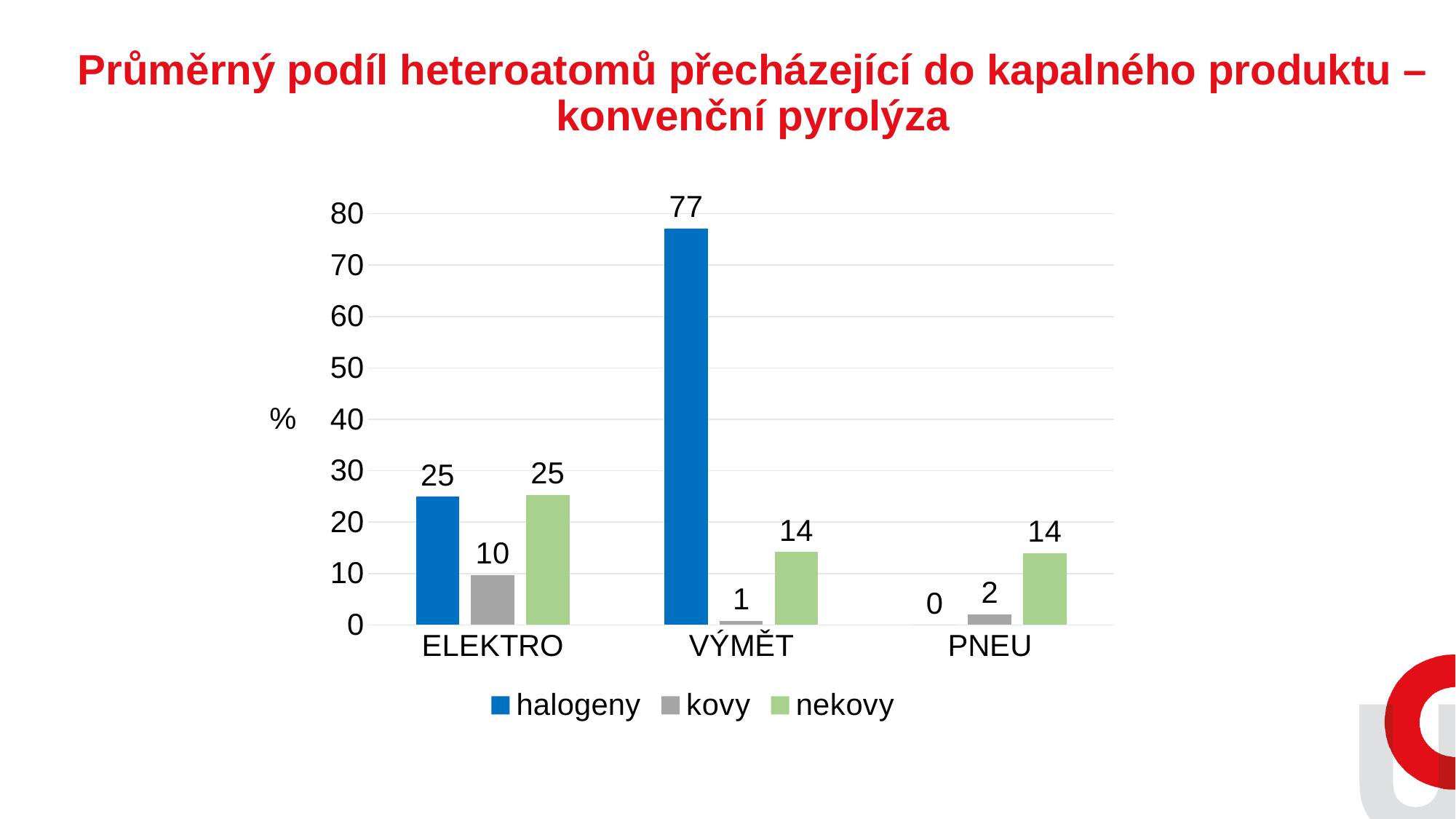
What is the value for kovy in the ELEKTRO category? 10 What is the value for halogeny in the VÝMĚT category? 77 What is the difference between the halogeny values for VÝMĚT and ELEKTRO? 52 What is the value for nekovy in the PNEU category? 14 What is the value for halogeny in the PNEU category? 0 Which is larger: the nekovy value for ELEKTRO or the nekovy value for VÝMĚT? ELEKTRO How many series does the legend list? 3 Which category has the highest halogeny value? VÝMĚT Which category has the lowest kovy value? VÝMĚT What kind of chart is shown on the slide? bar chart Is the halogeny value for VÝMĚT greater or less than 70? greater How many categories are shown on the x axis? 3